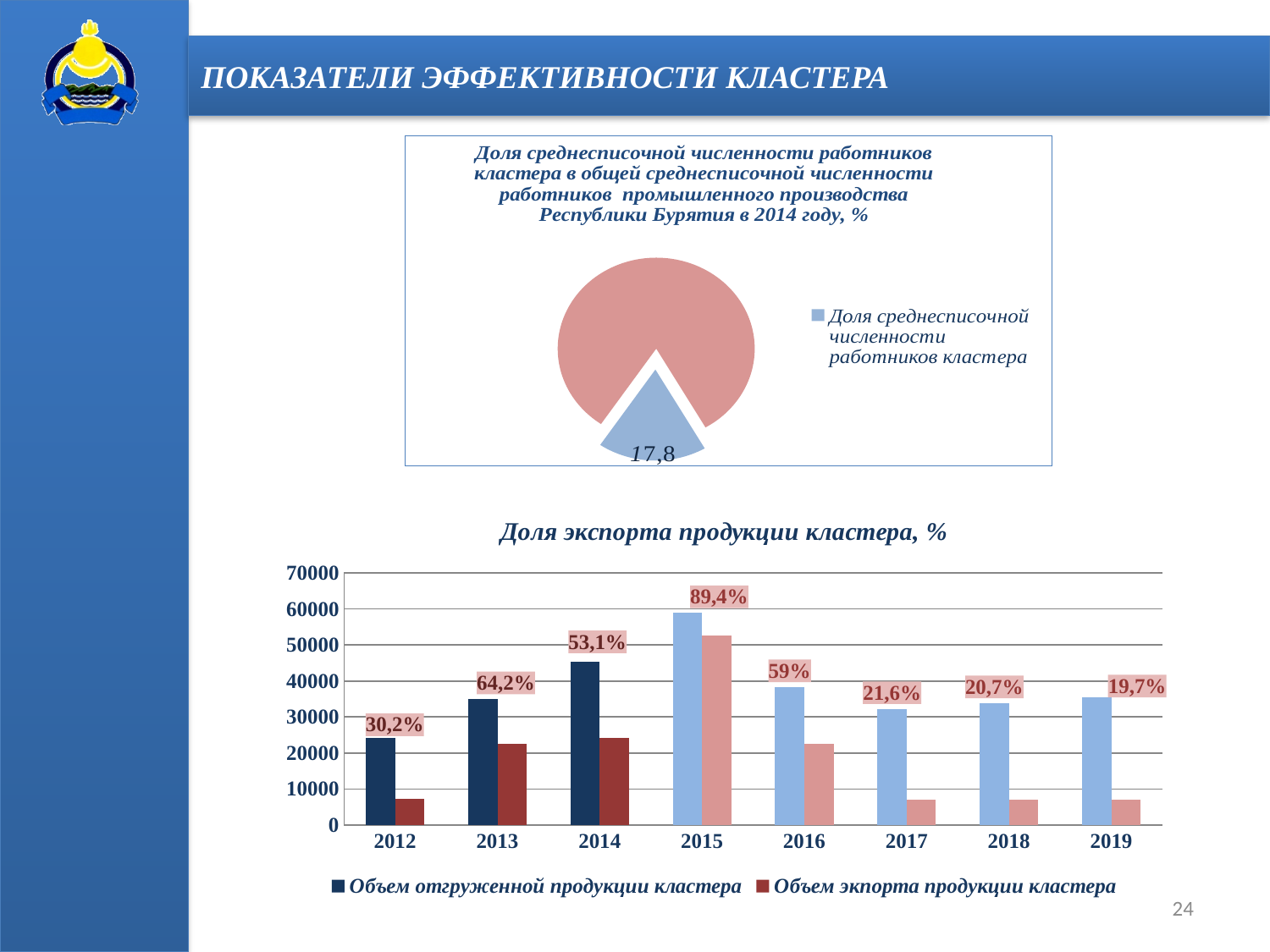
In the top pie chart, what value is printed on the highlighted slice? 17,8 In the top pie chart, what is the legend entry shown? Доля среднесписочной численности работников кластера In the bottom chart 'Доля экспорта продукции кластера, %', is the value of 'Объем отгруженной продукции кластера' for 2015 greater or less than 50000? greater In the bottom chart 'Доля экспорта продукции кластера, %', what is the difference between the percentage labels for 2015 and 2019? 69,7% In the bottom chart 'Доля экспорта продукции кластера, %', what percentage label is shown for 2013? 64,2% In the bottom chart 'Доля экспорта продукции кластера, %', how many series does the legend list? 2 What kind of chart is the bottom chart titled 'Доля экспорта продукции кластера, %'? bar chart In the bottom chart 'Доля экспорта продукции кластера, %', how many years are shown on the x axis? 8 What kind of chart is the top chart on the slide (Доля среднесписочной численности работников кластера...)? pie chart In the bottom chart 'Доля экспорта продукции кластера, %', which year has the highest percentage label? 2015 In the bottom chart 'Доля экспорта продукции кластера, %', what percentage label is shown for 2015? 89,4% In the bottom chart 'Доля экспорта продукции кластера, %', which year has the lowest percentage label? 2019